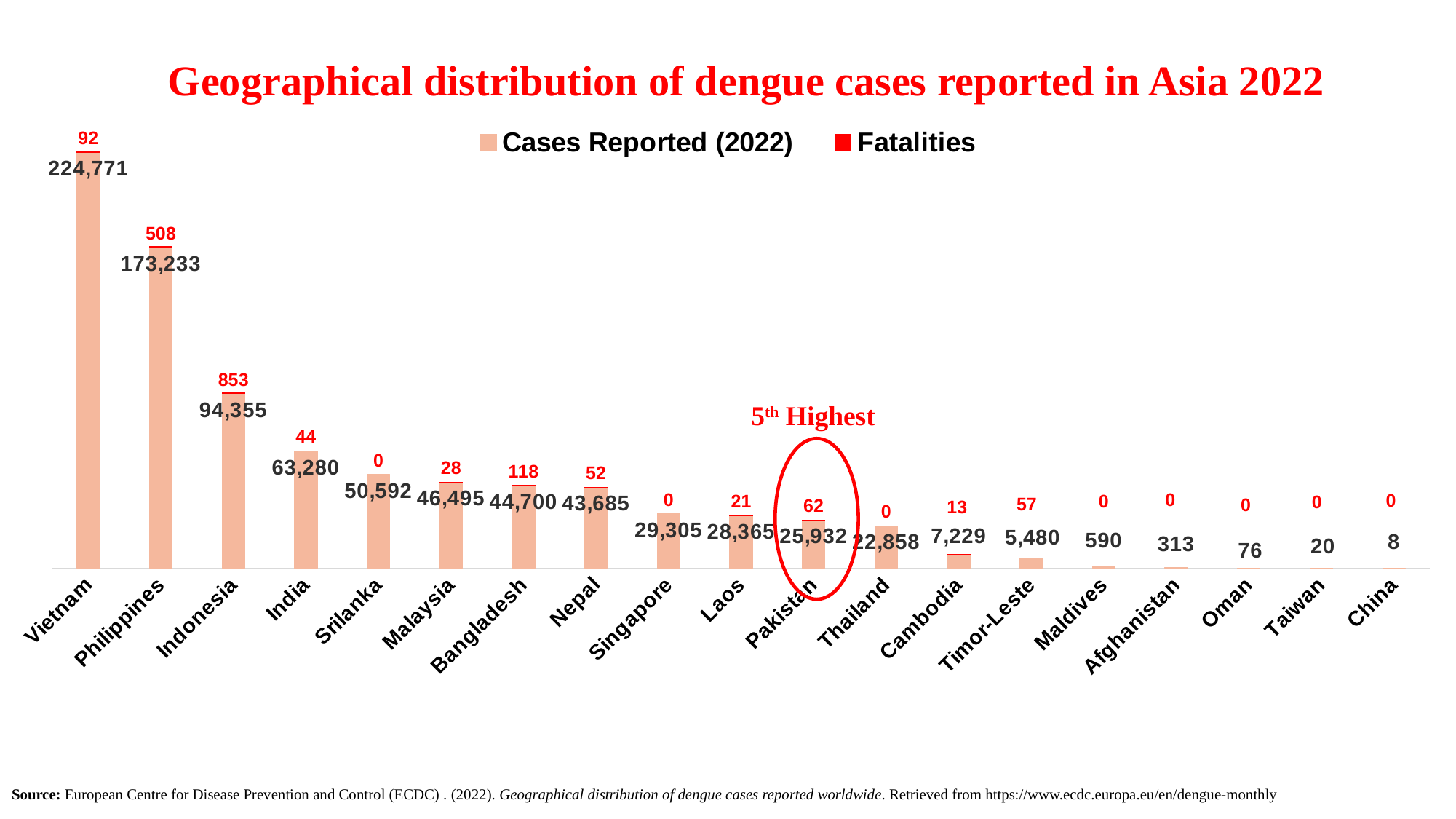
How many fatalities are shown for Indonesia? 853 How many cases were reported in Pakistan? 25,932 Do the cases reported rise or fall moving from left to right along the x axis? Fall Which country has the highest number of fatalities? Indonesia How many series does the legend list? 2 How many cases were reported in Vietnam in 2022? 224,771 Which country has the highest number of cases reported? Vietnam What kind of chart is shown on the slide? Bar chart What is the difference in cases reported between Vietnam and the Philippines? 51,538 Which has more cases reported, India or Srilanka? India Which country has the lowest number of cases reported? China How many countries are shown on the x axis? 19